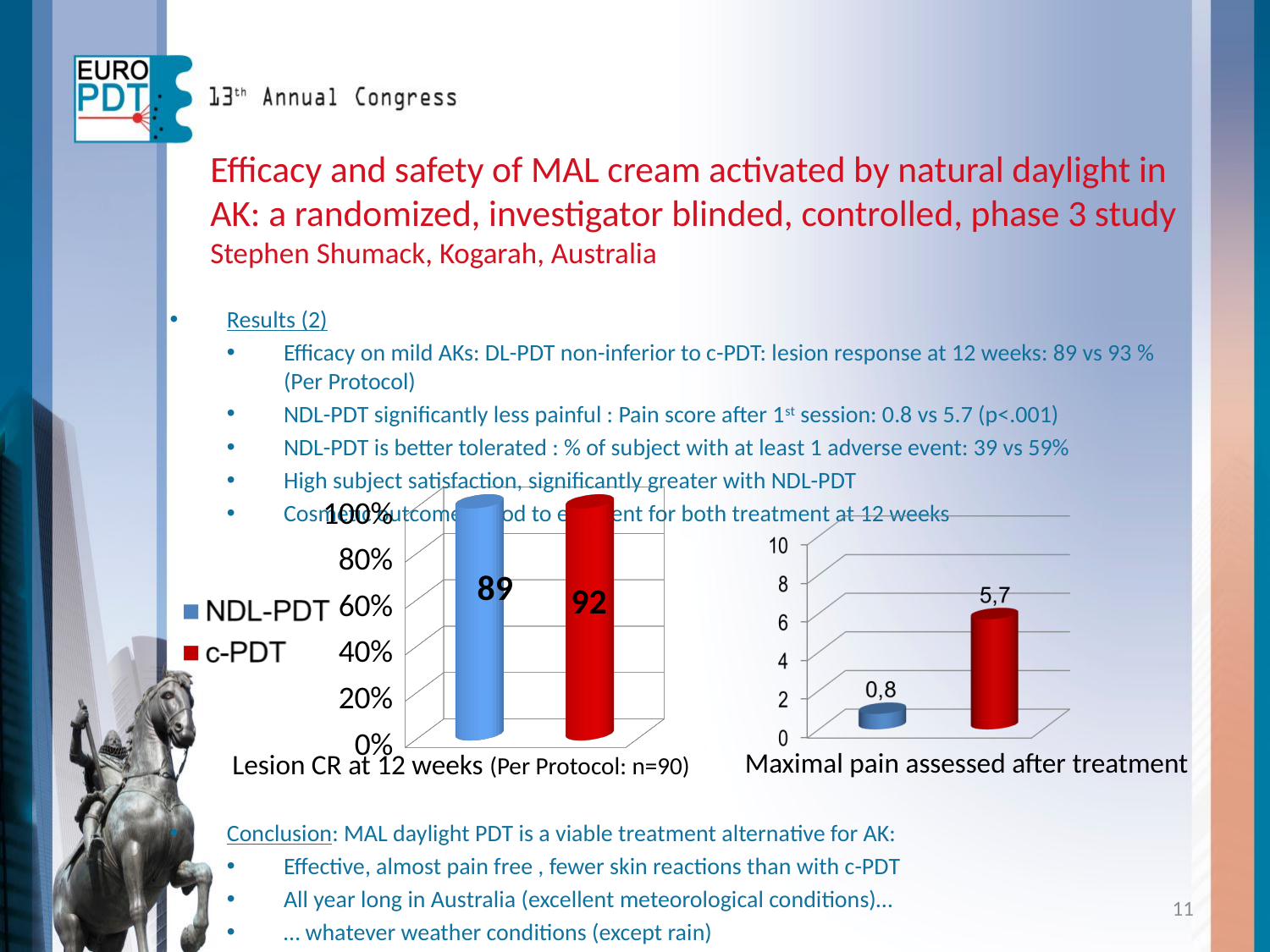
In the 'Maximal pain assessed after treatment' chart, which treatment has the lower pain score? NDL-PDT In the 'Maximal pain assessed after treatment' chart, is the value for NDL-PDT greater or less than 2? less What type of chart is the 'Lesion CR at 12 weeks' chart? Bar chart In the 'Lesion CR at 12 weeks' chart, what is the value for c-PDT? 92 In the 'Lesion CR at 12 weeks' chart, what is the value for NDL-PDT? 89 In the 'Lesion CR at 12 weeks' chart, what is the difference between the c-PDT and NDL-PDT values? 3 In the 'Maximal pain assessed after treatment' chart, what is the value for c-PDT (red bar)? 5,7 In the 'Lesion CR at 12 weeks' chart, which treatment has the higher value? c-PDT How many series does the legend list for the charts? 2 In the 'Maximal pain assessed after treatment' chart, is the value for c-PDT greater or less than 4? greater In the 'Maximal pain assessed after treatment' chart, what is the value for NDL-PDT (blue bar)? 0,8 Which colour represents c-PDT in the legend? Red